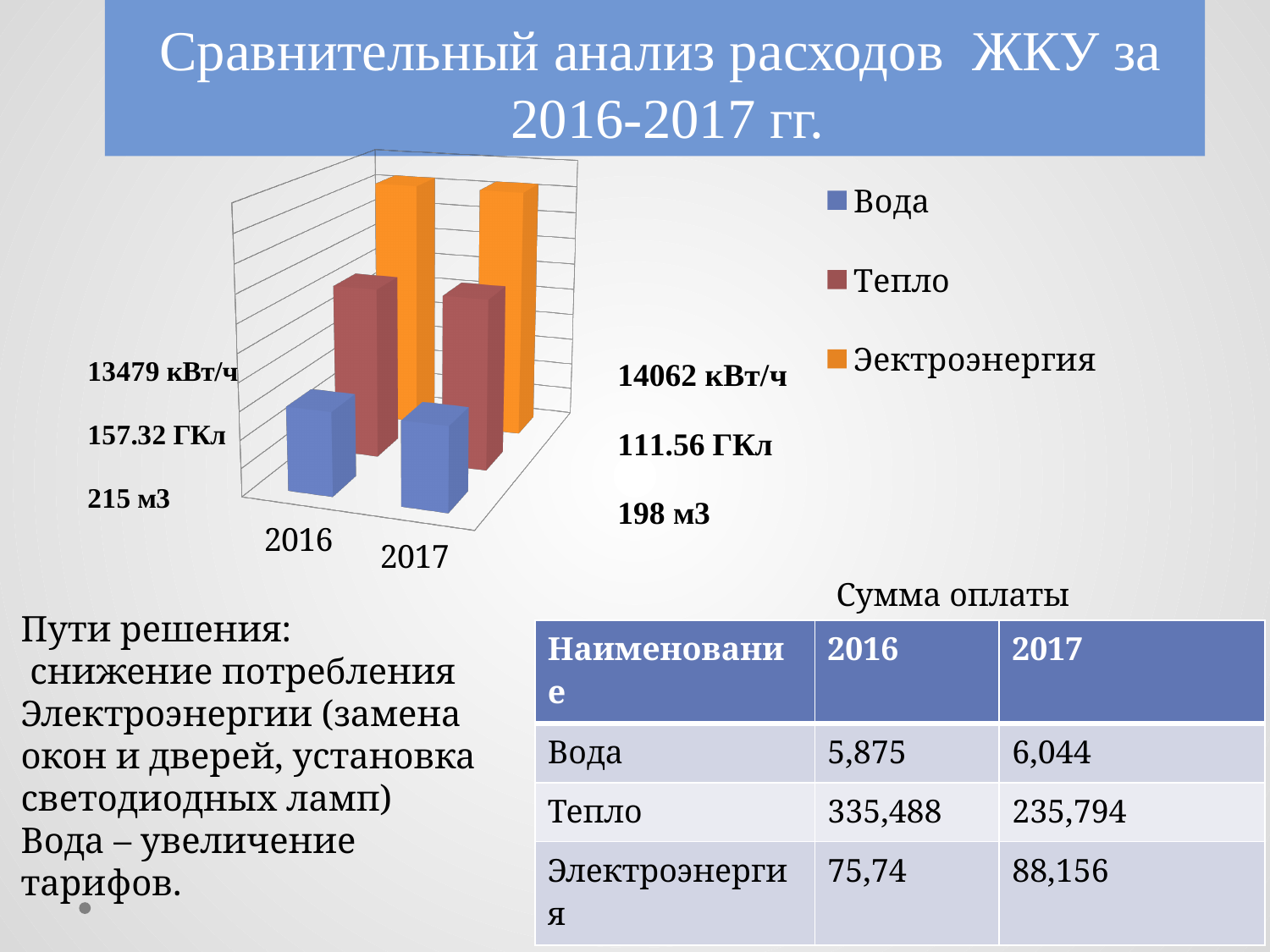
What is the difference between the water (Вода) values for 2016 and 2017 on the chart? 17 м3 How many series does the chart legend list? 3 What is the labelled electricity value for 2016 on the chart? 13479 кВт/ч How many year categories are shown on the chart's x axis? 2 Which series has the tallest bar for 2016 on the chart? Эектроэнергия What is the labelled water (Вода) value for 2016 on the chart? 215 м3 By how much did the heat (Тепло) value decrease from 2016 to 2017 according to the chart labels? 45.76 ГКл Which year has the larger heat (Тепло) value on the chart, 2016 or 2017? 2016 What kind of chart is shown on the slide? bar chart What is the labelled heat (Тепло) value for 2017 on the chart? 111.56 ГКл What is the labelled electricity value for 2017 on the chart? 14062 кВт/ч Which series is shown in orange in the chart legend? Эектроэнергия